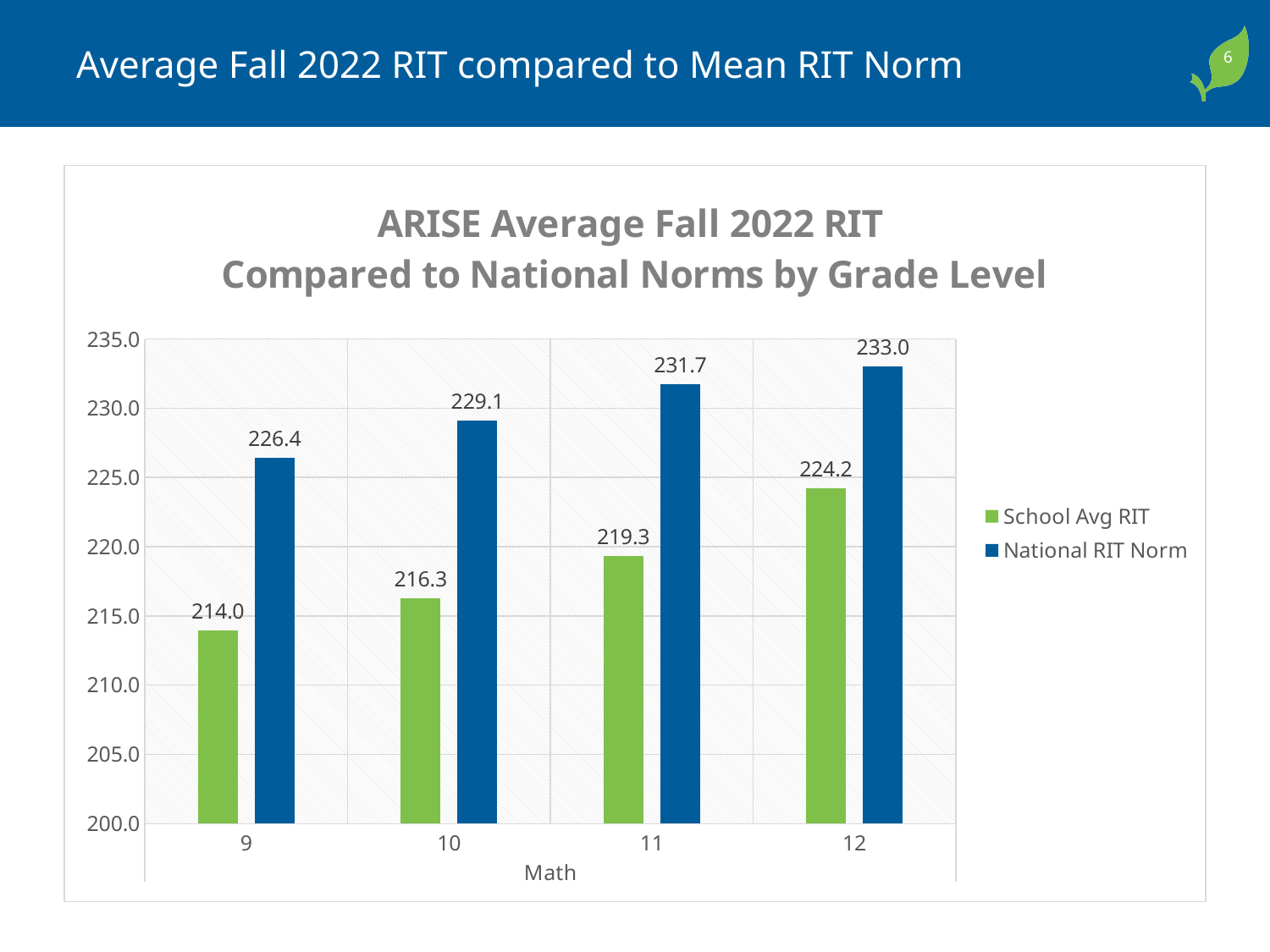
What kind of chart is shown? bar chart Which grade has the lowest School Avg RIT? 9 What is the School Avg RIT for grade 12? 224.2 Which is larger for grade 11, the School Avg RIT or the National RIT Norm? National RIT Norm Is the School Avg RIT for grade 12 greater or less than 225.0? less What is the difference between the National RIT Norm and the School Avg RIT for grade 10? 12.8 What is the National RIT Norm for grade 11? 231.7 What is the School Avg RIT for grade 9? 214.0 Which grade has the highest National RIT Norm? 12 How many series does the legend list? 2 Does the School Avg RIT rise or fall from grade 9 to grade 12? rise How many grade levels are shown on the x axis? 4